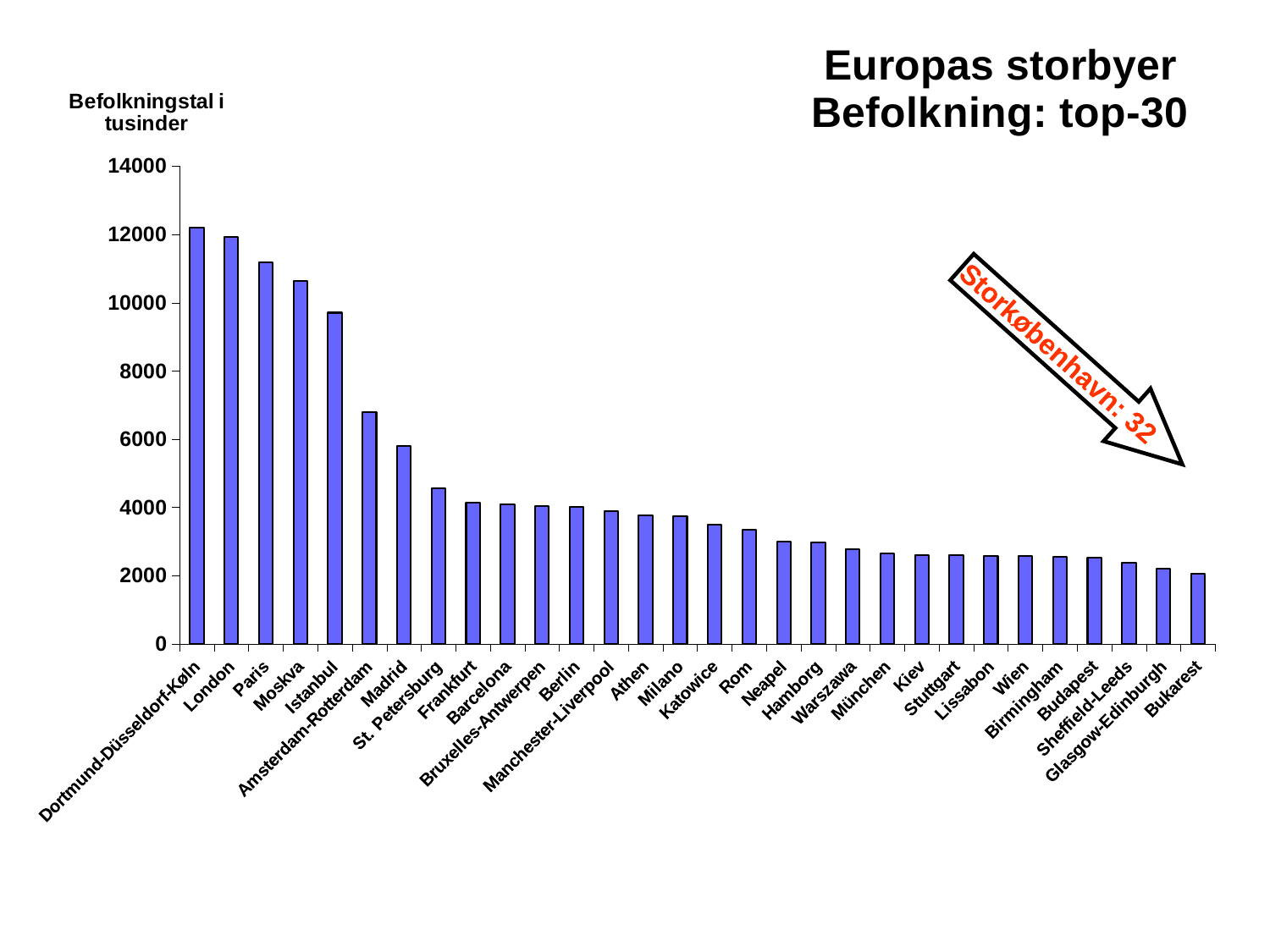
Is the value for Amsterdam-Rotterdam greater or less than 6000? greater How many cities are shown on the x axis of the chart? 30 Is the value for Istanbul greater or less than 8000? greater Which has the larger value, Paris or Moskva? Paris Which has the larger value, Madrid or St. Petersburg? Madrid Is the value for Bukarest greater or less than 4000? less What kind of chart is shown on the slide? bar chart Do the values rise or fall from left to right along the x axis? fall What is the title of the chart? Europas storbyer Befolkning: top-30